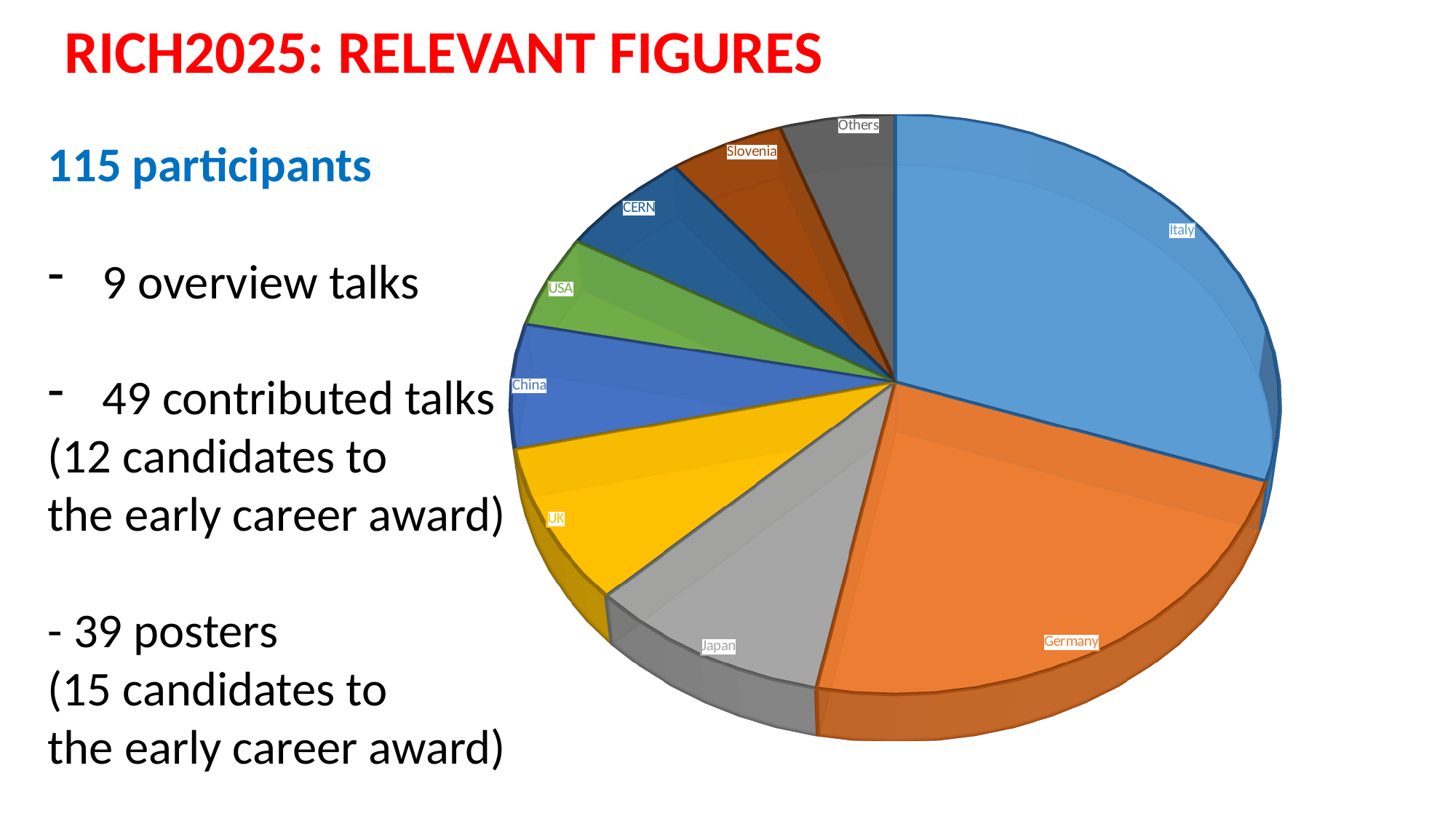
Which slice of the pie chart is the largest? Italy Which slice is larger in the pie chart, Japan or UK? Japan Which slice is larger in the pie chart, China or Italy? Italy What colour is the Germany slice in the pie chart? orange Which slice is larger in the pie chart, Italy or Germany? Italy Which slice of the pie chart is coloured green? USA How many slices does the pie chart have? 9 What kind of chart is shown on the slide? pie chart